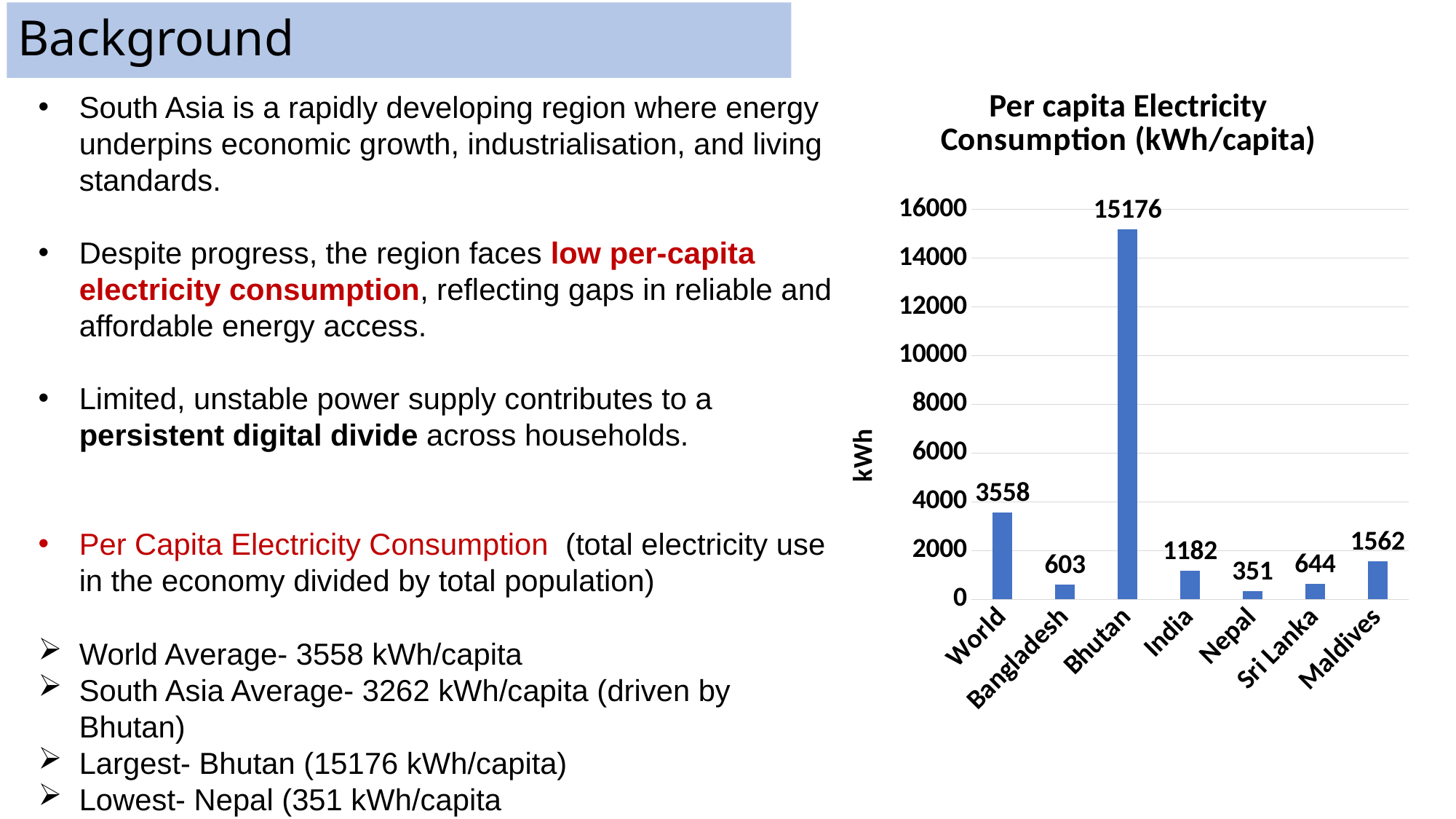
Which category has the lowest value in the chart? Nepal What is the value shown for Maldives in the chart? 1562 What is the difference between the values for World and India? 2376 What is the title of the chart? Per capita Electricity Consumption (kWh/capita) What is the per capita electricity consumption value shown for Bhutan? 15176 Which category has the highest value in the chart? Bhutan What is the difference between the values for Sri Lanka and Nepal? 293 Is the value for World greater or less than 4000? less What is the value shown for Bangladesh in the chart? 603 How many categories are shown on the x axis of the chart? 7 Which has a larger value, Maldives or India? Maldives What kind of chart is shown on the slide? bar chart